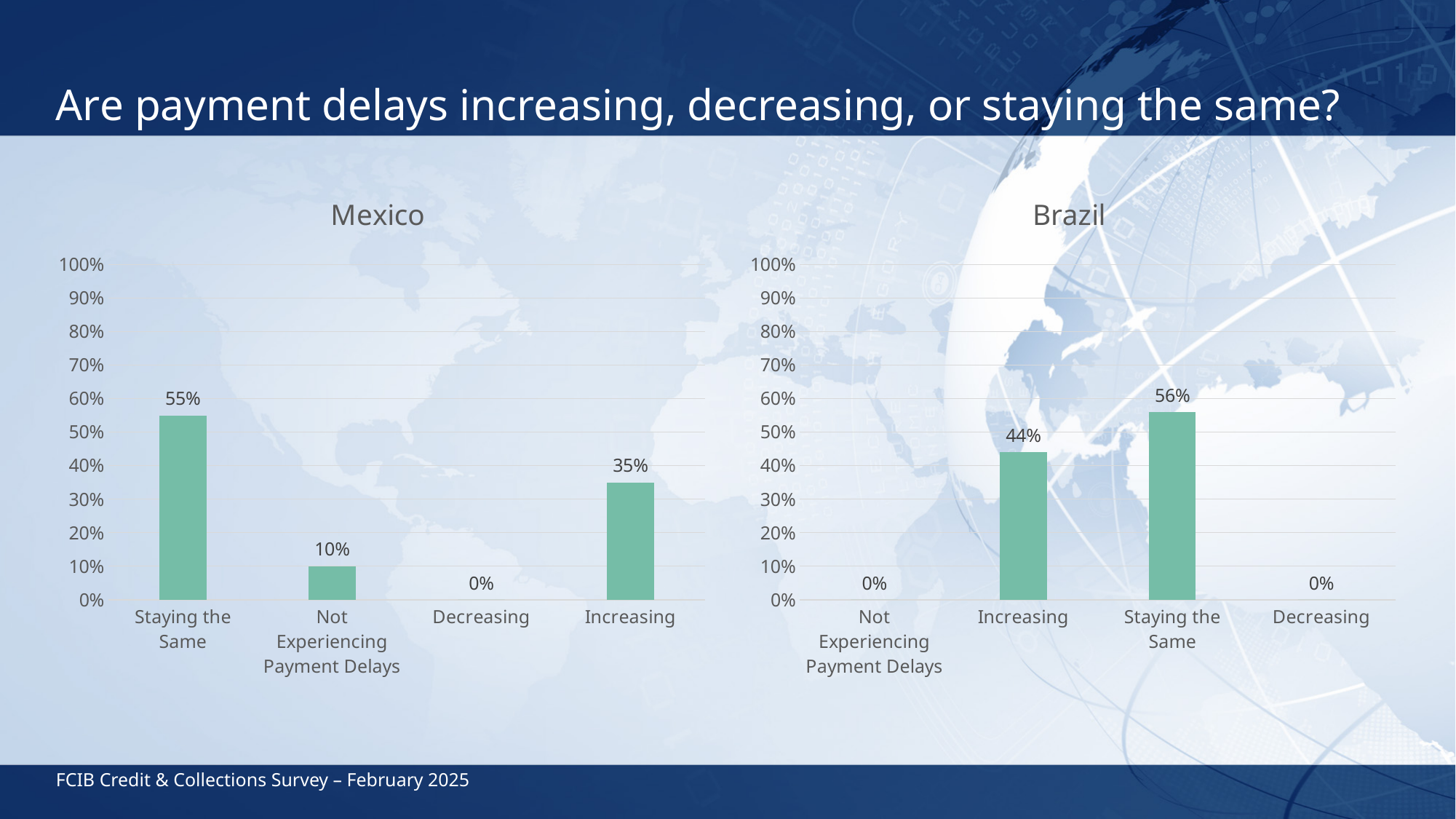
In the Mexico chart, what is the difference between Staying the Same and Increasing? 20% How many categories are shown in the Mexico chart? 4 In the Mexico chart, what is the value for Staying the Same? 55% In the Mexico chart, which category has the highest value? Staying the Same In the Brazil chart, what is the value for Not Experiencing Payment Delays? 0% What kind of chart is the Brazil chart? Bar chart In the Brazil chart, what is the difference between Staying the Same and Increasing? 12% In the Brazil chart, what is the value for Increasing? 44% In the Brazil chart, which category has the highest value? Staying the Same What is the title of the chart on the left side of the slide? Mexico Which is larger: Increasing in the Mexico chart or Increasing in the Brazil chart? Brazil In the Mexico chart, what is the value for Increasing? 35%